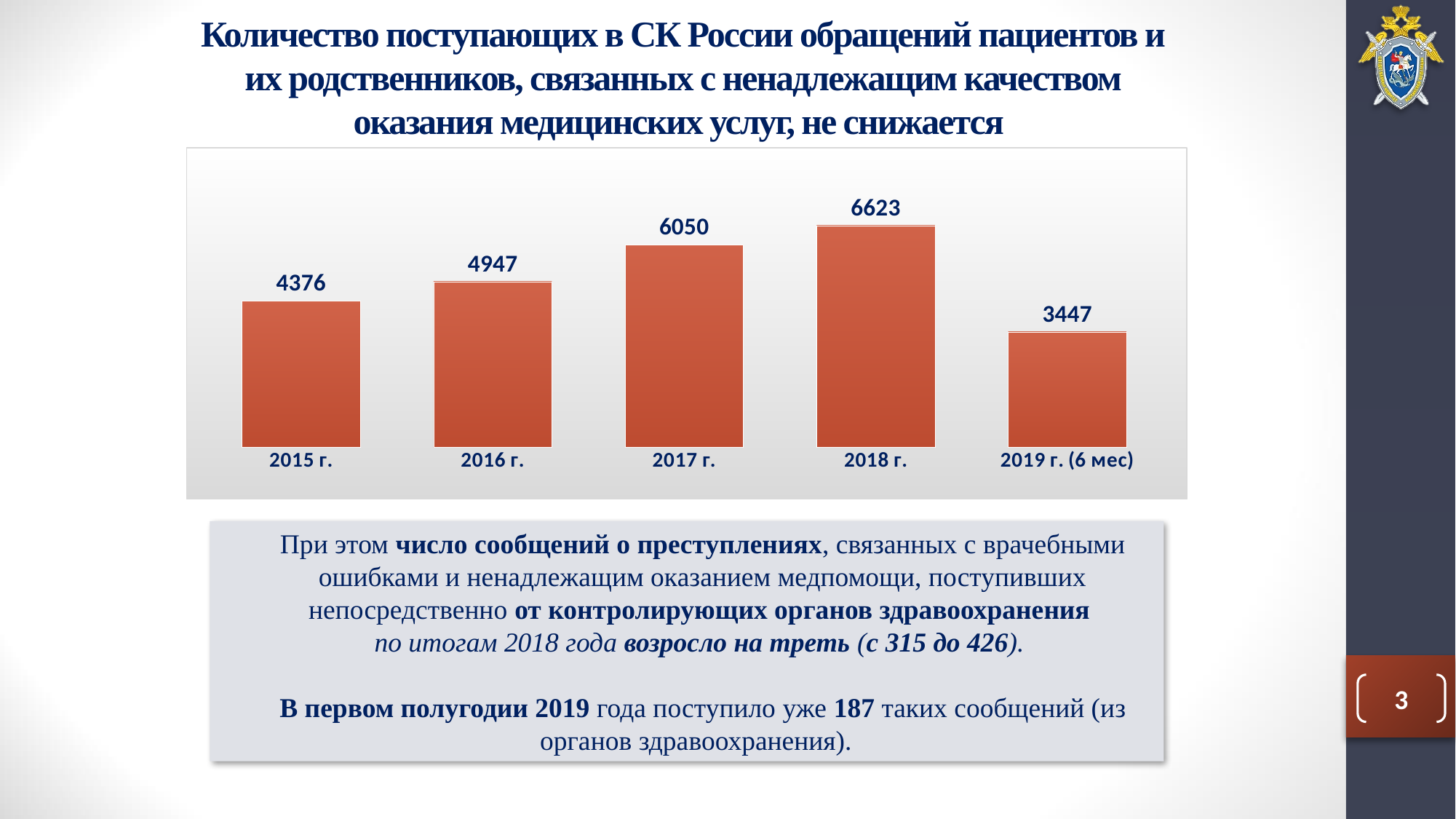
Do the values rise or fall from 2015 г. to 2018 г.? rise What is the value for 2015 г.? 4376 What is the value for 2017 г.? 6050 What kind of chart is shown on the slide? bar chart What is the difference between the values for 2018 г. and 2017 г.? 573 What colour are the bars on the chart? red-orange Which is larger, the value for 2016 г. or the value for 2019 г. (6 мес)? 2016 г. What is the value for 2019 г. (6 мес)? 3447 How many categories are shown on the chart? 5 Which category has the lowest value? 2019 г. (6 мес) Which category has the highest value? 2018 г. What is the difference between the values for 2016 г. and 2015 г.? 571